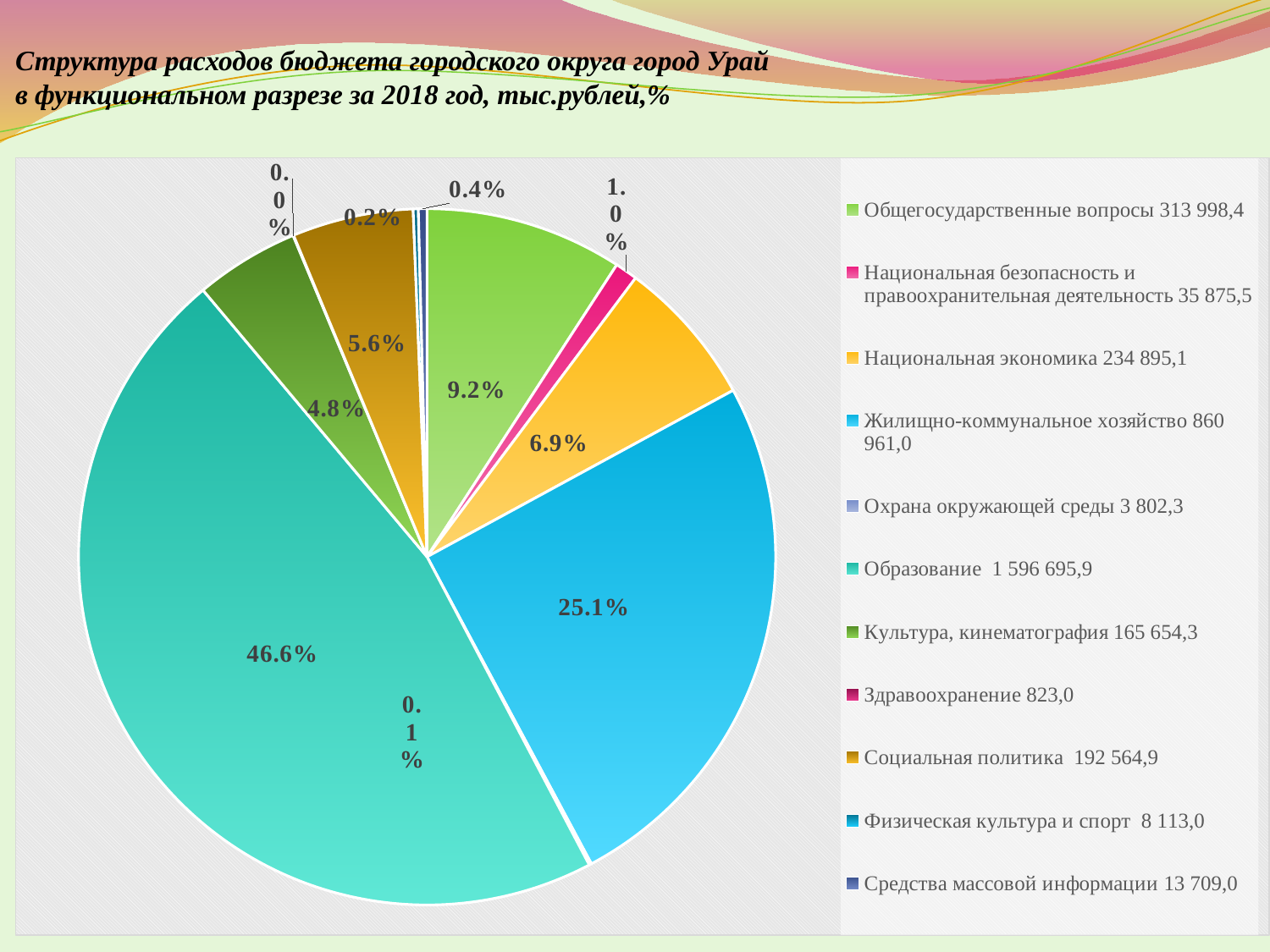
What value is shown in the legend for Социальная политика? 192 564,9 What kind of chart is shown on the slide? pie chart What is the difference in percentage points between the Образование slice (46.6%) and the Жилищно-коммунальное хозяйство slice (25.1%)? 21.5 What percentage share of the pie is labelled for Жилищно-коммунальное хозяйство? 25.1% Which category has the largest slice of the pie? Образование What percentage share of the pie is labelled for Образование? 46.6% What year does the chart title say the budget expenditure structure refers to? 2018 What value is shown in the legend for Охрана окружающей среды? 3 802,3 Which slice is larger: Культура, кинематография or Социальная политика? Социальная политика What percentage share of the pie is labelled for Общегосударственные вопросы? 9.2% How many categories does the legend of the pie chart list? 11